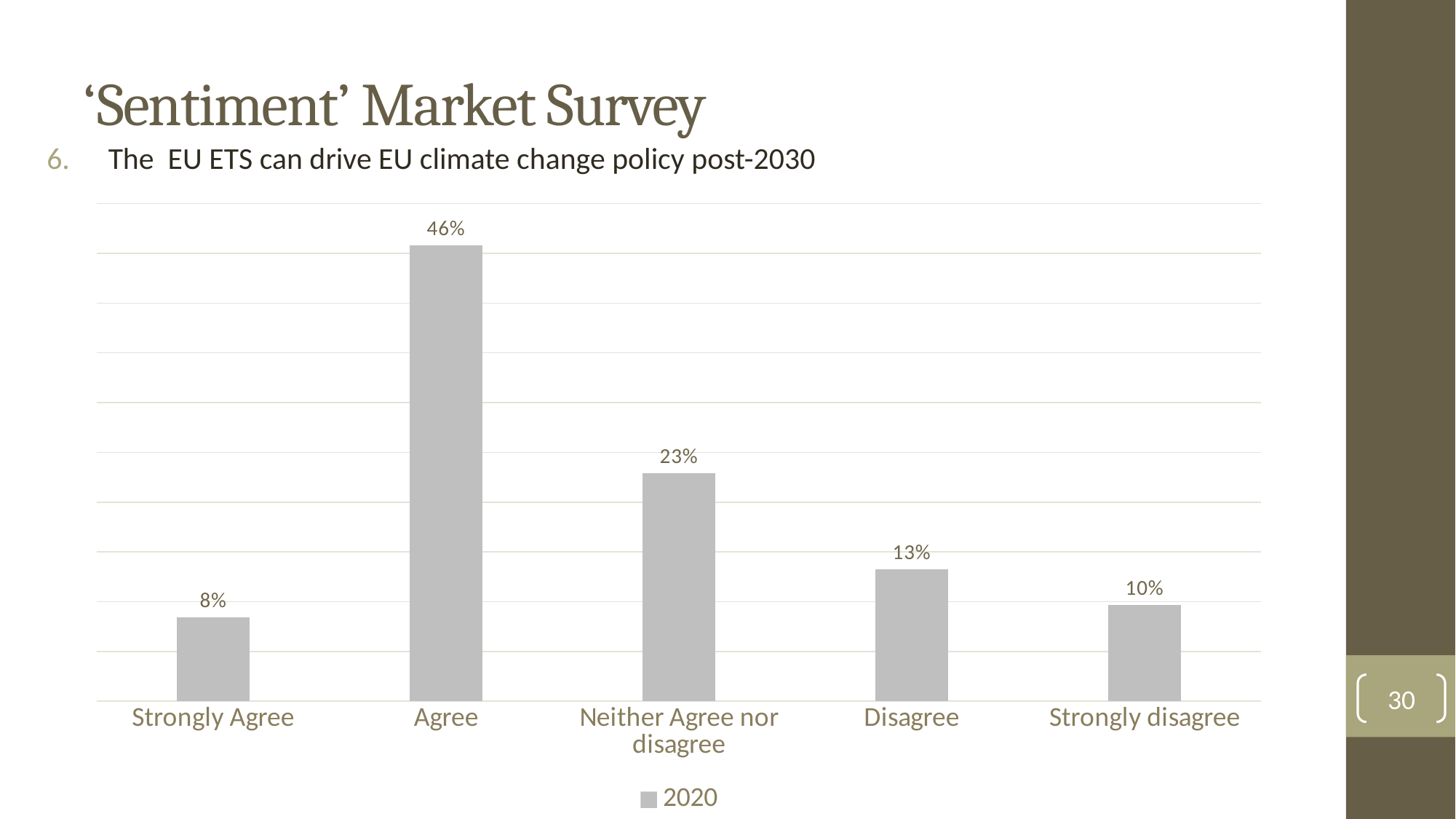
What is the value for 'Strongly disagree'? 10% What is the value for 'Strongly Agree'? 8% Which category has the highest value? Agree How many categories are shown on the x axis? 5 What percentage of respondents chose 'Agree'? 46% What series name is shown in the legend? 2020 What kind of chart is shown on the slide? Bar chart Which is larger, the value for 'Disagree' or the value for 'Strongly disagree'? Disagree What is the difference between the 'Agree' and 'Neither Agree nor disagree' values? 23% Which category has the lowest value? Strongly Agree How many series does the legend list? 1 What is the value for 'Neither Agree nor disagree'? 23%